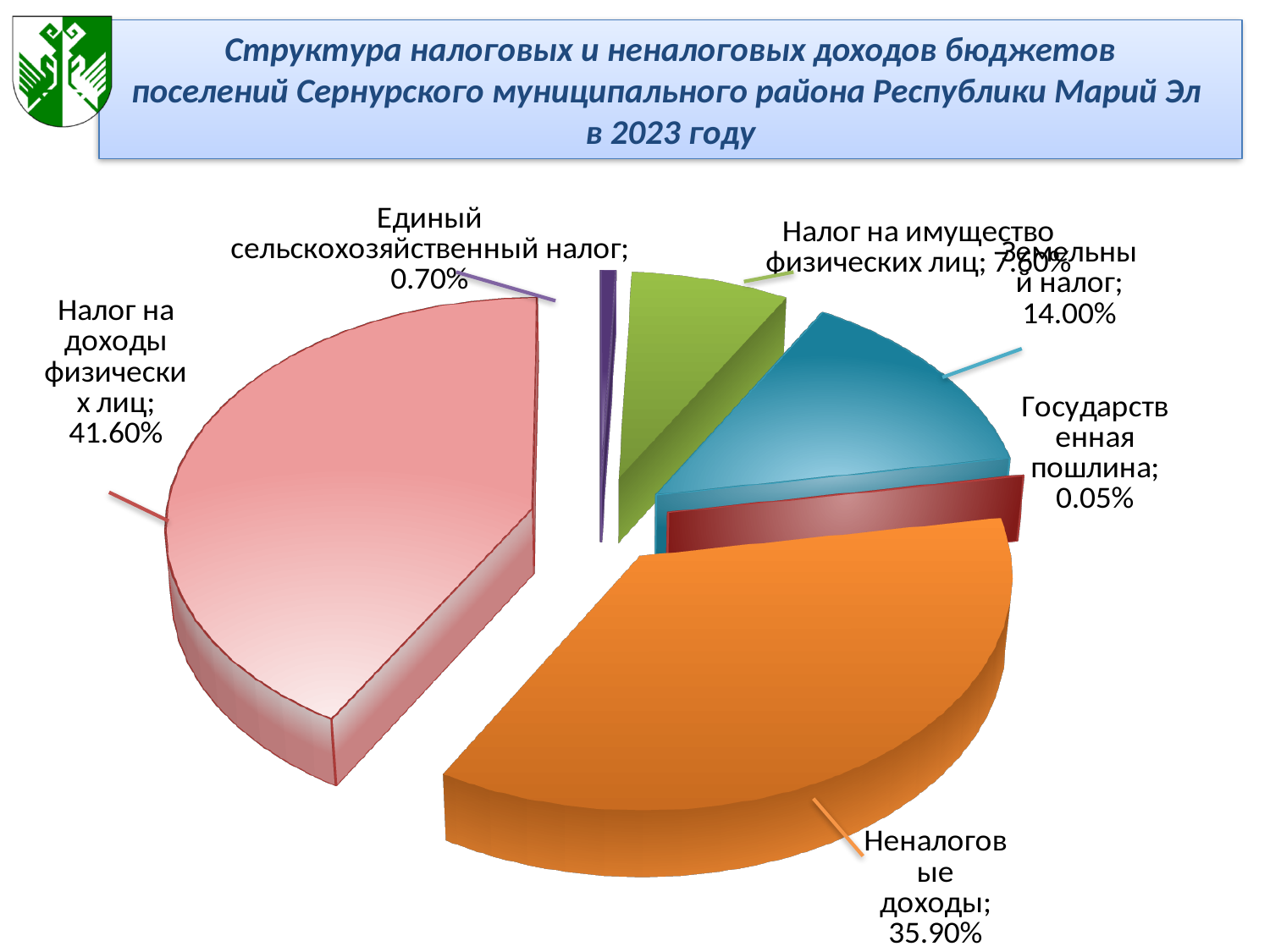
By how many percentage points does "Налог на доходы физических лиц" exceed "Неналоговые доходы"? 5.70 percentage points Which category has the largest share in the pie chart? Налог на доходы физических лиц Which category has the smallest share in the pie chart? Государственная пошлина What share does "Налог на доходы физических лиц" have in the pie chart? 41.60% What share does "Единый сельскохозяйственный налог" have in the pie chart? 0.70% What colour is the "Неналоговые доходы" slice in the pie chart? Orange What share does "Неналоговые доходы" have in the pie chart? 35.90% What share does "Государственная пошлина" have in the pie chart? 0.05% What share does "Земельный налог" have in the pie chart? 14.00% Which has the larger share: "Земельный налог" or "Единый сельскохозяйственный налог"? Земельный налог What kind of chart is shown on the slide? Pie chart How many categories (slices) does the pie chart show? 6